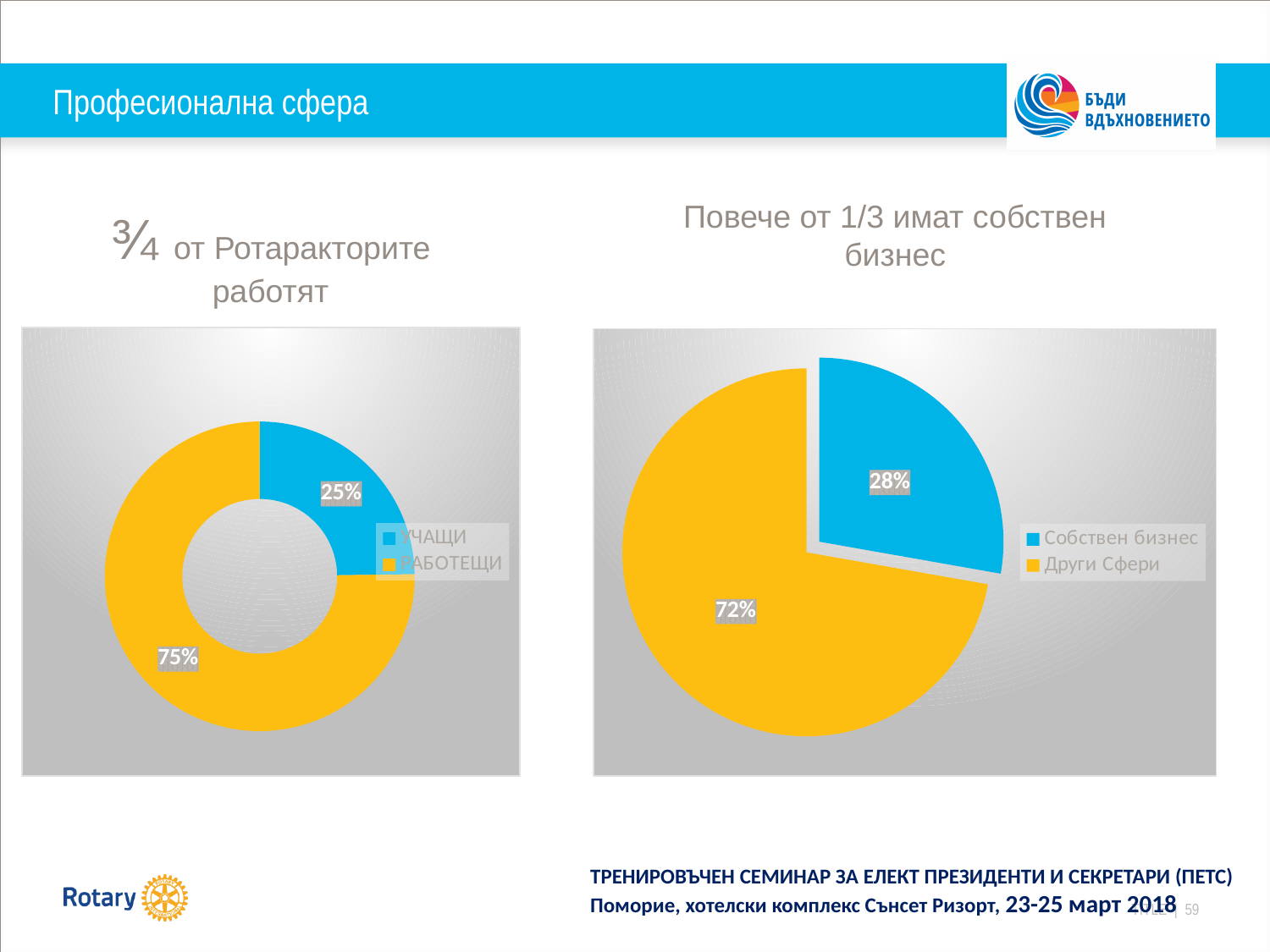
What type of chart is the left chart? doughnut chart In the right chart, what colour is the Собствен бизнес slice? blue In the left chart, which category has the larger share? РАБОТЕЩИ What type of chart is the right chart? pie chart In the right chart, what percentage is shown for Други Сфери? 72% In the left chart, what is the difference in percentage points between РАБОТЕЩИ and УЧАЩИ? 50 In the left chart, what percentage is shown for РАБОТЕЩИ? 75% In the left chart, how many categories does the legend list? 2 In the left chart, what percentage is shown for УЧАЩИ? 25% In the right chart, what percentage is shown for Собствен бизнес? 28% In the right chart, which category has the smaller share? Собствен бизнес In the right chart, what is the difference in percentage points between Други Сфери and Собствен бизнес? 44